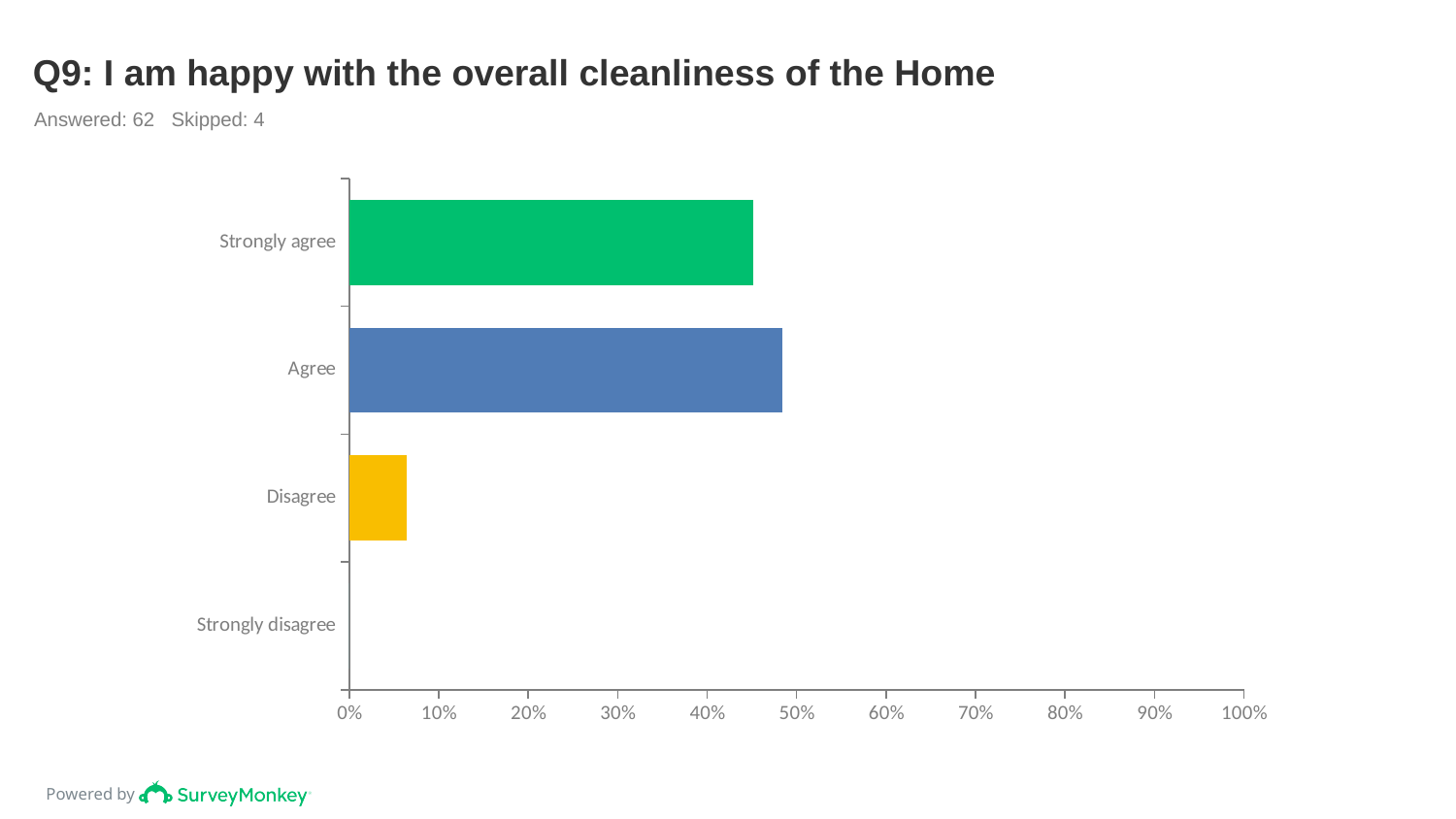
Is the value for Agree greater or less than 50%? less What is the title of the chart? Q9: I am happy with the overall cleanliness of the Home Is the value for Disagree greater or less than 10%? less Which is larger, the value for Strongly agree or the value for Disagree? Strongly agree How many response categories are shown on the chart? 4 How many respondents answered this question according to the slide? 62 Which response category has the lowest value? Strongly disagree What kind of chart is shown on the slide? bar chart Which is larger, the value for Disagree or the value for Strongly disagree? Disagree What is the value for Strongly disagree? 0% Is the value for Strongly agree greater or less than 40%? greater